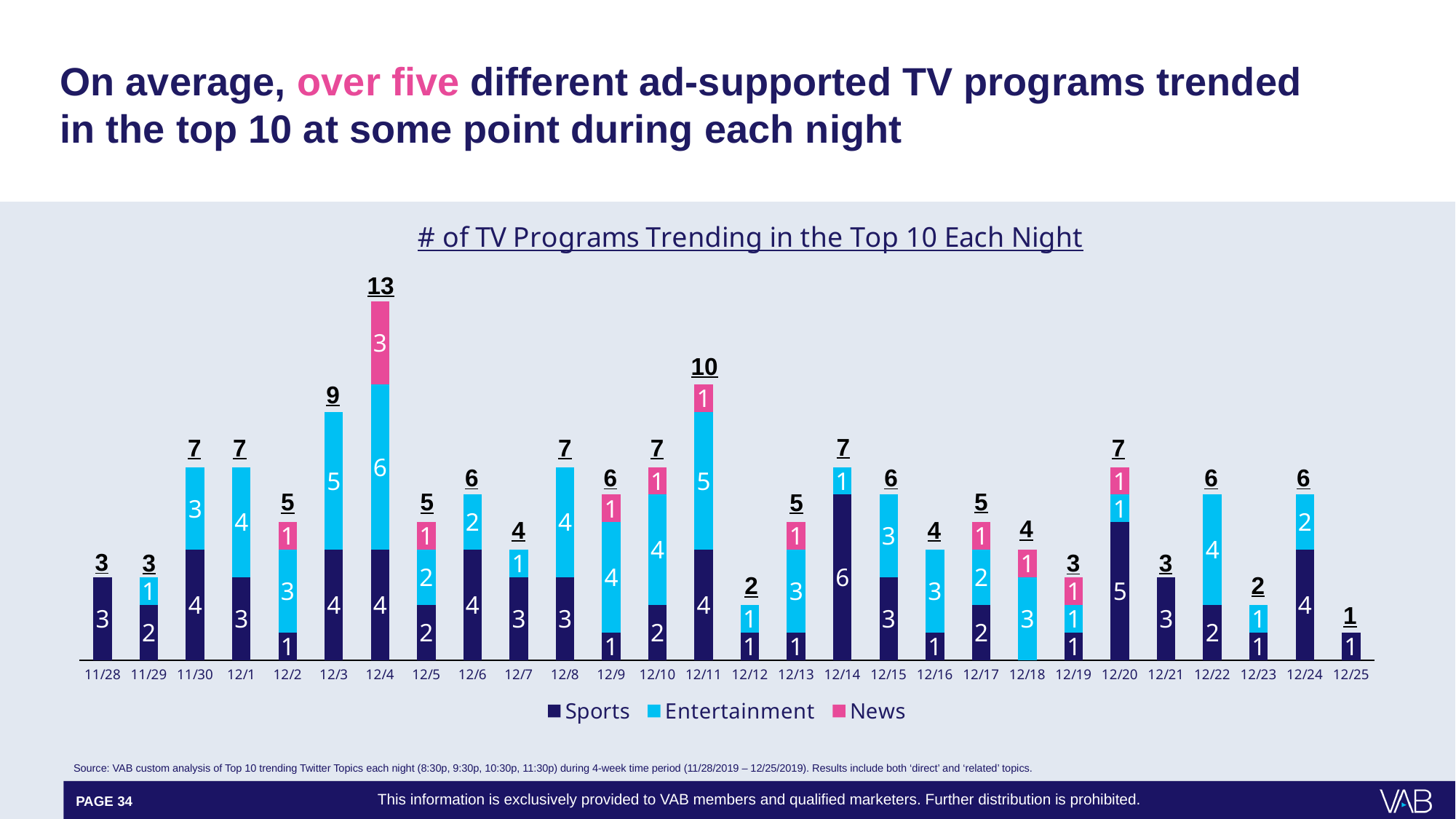
How many nights are shown on the x axis of the chart? 28 What is the total number of TV programs trending on 12/4? 13 Which night has a larger total, 12/3 or 12/8? 12/3 How many Sports programs trended on 12/14? 6 Which night has the highest total number of TV programs trending in the top 10? 12/4 What is the difference between the total for 12/11 and the total for 12/12? 8 How many series does the legend list? 3 Which series is shown in pink in the chart? News How many News programs trended on 12/4? 3 What kind of chart is shown on the slide? Stacked bar chart How many Entertainment programs trended on 12/3? 5 Which night has the lowest total number of TV programs trending in the top 10? 12/25